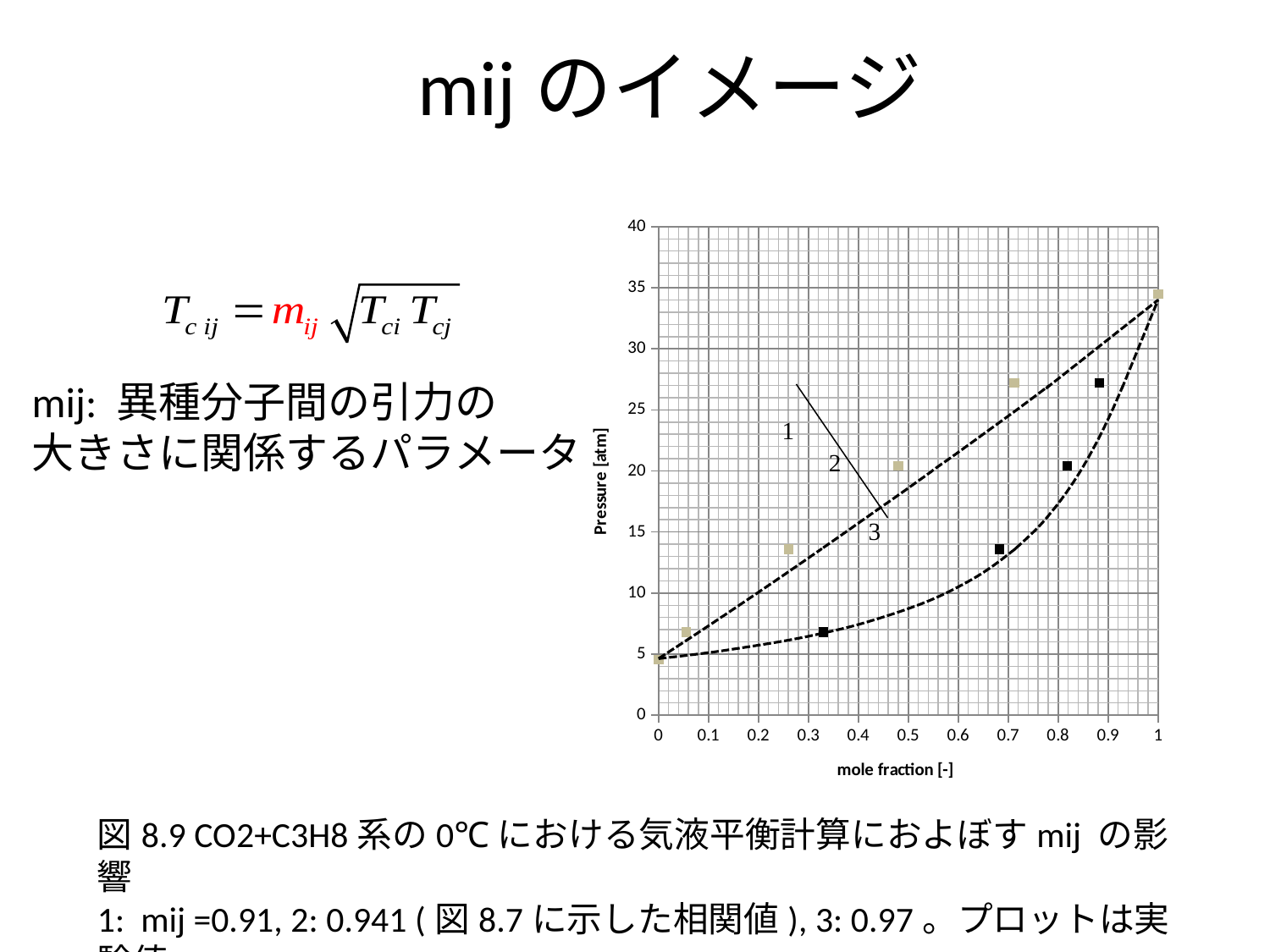
What is the maximum value shown on the y axis of the chart? 40 Does the pressure rise or fall as the mole fraction increases from 0 to 1? rise What is the title of the x axis of the chart? mole fraction [-] What is the title of the y axis of the chart? Pressure [atm] How many numbered dashed curves (1, 2, 3) are labelled on the chart? 3 Is the pressure of the black point at mole fraction about 0.33 greater or less than 10 atm? less Is the pressure of the light-coloured point at mole fraction about 0.7 greater or less than 25 atm? greater Is the pressure of the point at mole fraction 1 greater or less than 30 atm? greater What kind of chart is shown on the slide? scatter chart Which has the higher pressure: the light-coloured point at mole fraction about 0.26 or the black point at mole fraction about 0.33? the light-coloured point at about 0.26